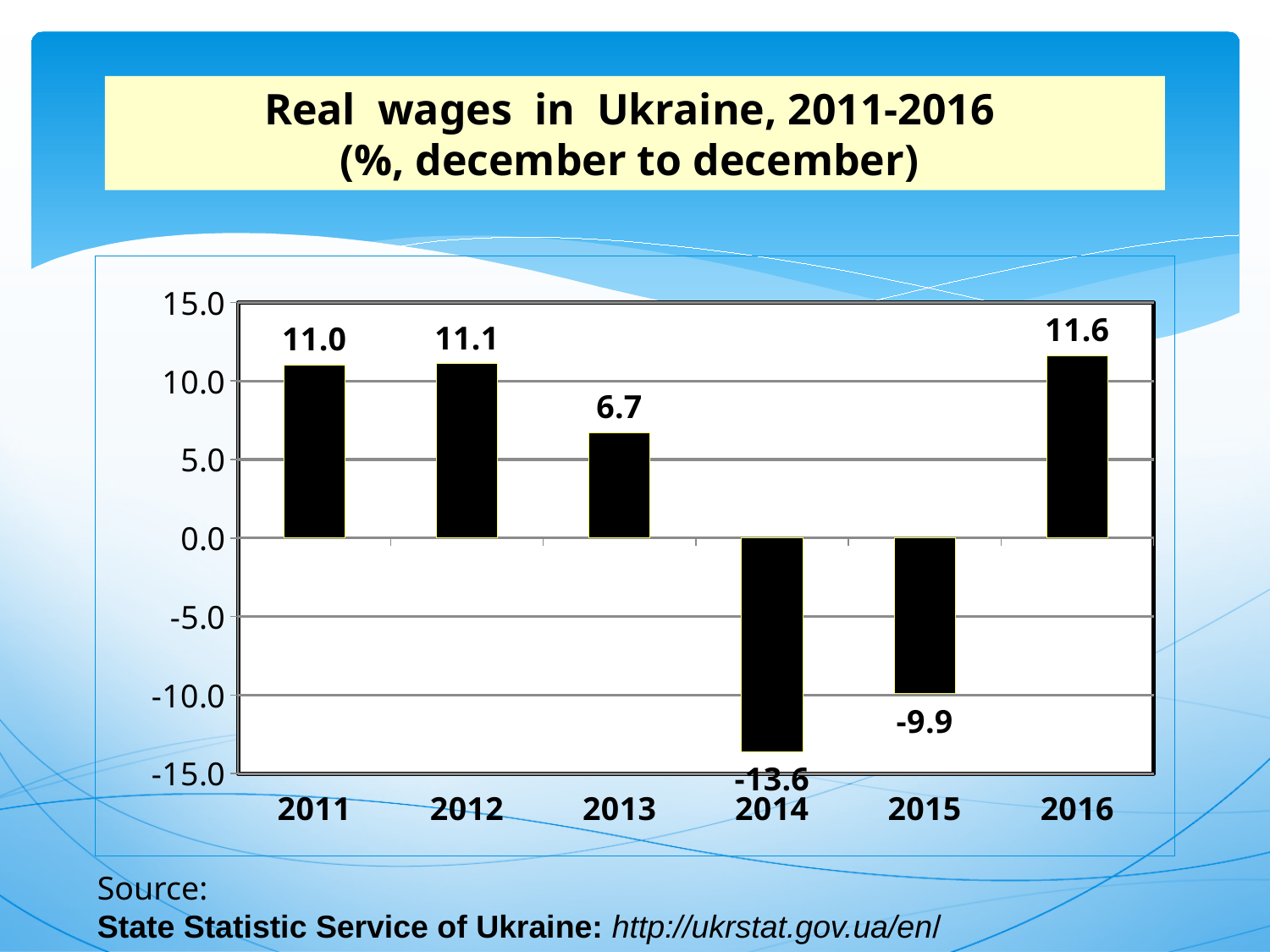
What value is shown for 2015? -9.9 What is the real wage change shown for 2013? 6.7 What is the title of the chart? Real wages in Ukraine, 2011-2016 (%, december to december) What value is shown for 2016? 11.6 Is the value for 2014 greater or less than -10.0? less Which year has the highest value? 2016 How many years are shown on the chart? 6 Which is larger, the value for 2011 or the value for 2013? 2011 What kind of chart is shown on the slide? bar chart What is the difference between the values for 2016 and 2013? 4.9 Which year has the lowest value? 2014 What is the difference between the values for 2015 and 2014? 3.7